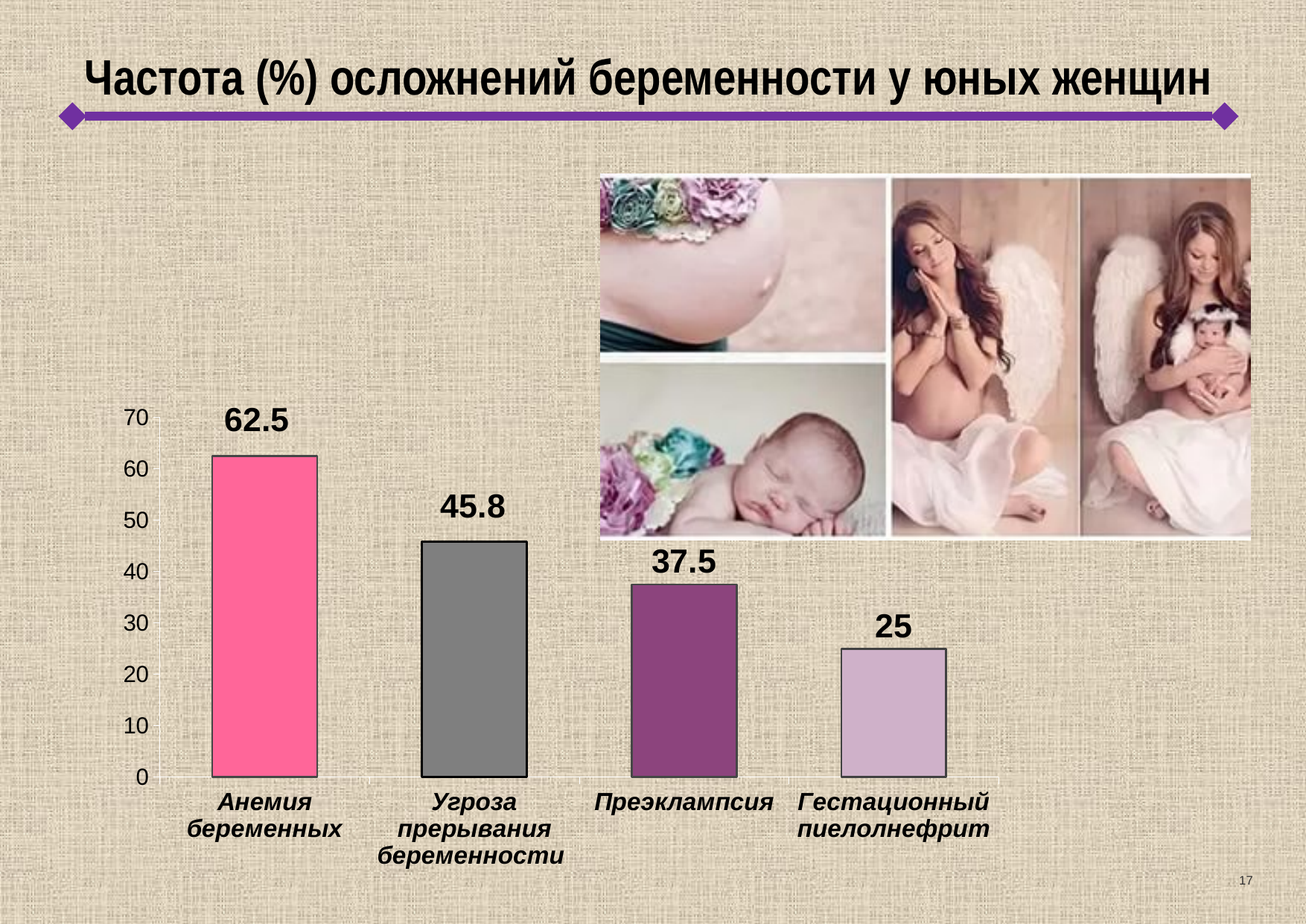
What is the value for Угроза прерывания беременности? 45.8 What is the value for Гестационный пиелолнефрит? 25 What is the value for Анемия беременных? 62.5 Which is larger, the value for Угроза прерывания беременности or the value for Преэклампсия? Угроза прерывания беременности Which category has the lowest value? Гестационный пиелолнефрит Which category has the highest value? Анемия беременных What is the difference between the values for Анемия беременных and Преэклампсия? 25 What kind of chart is shown on the slide? Bar chart Do the values rise or fall from left to right along the x axis? Fall What is the difference between the values for Угроза прерывания беременности and Гестационный пиелолнефрит? 20.8 How many categories are shown in the chart? 4 What is the value for Преэклампсия? 37.5